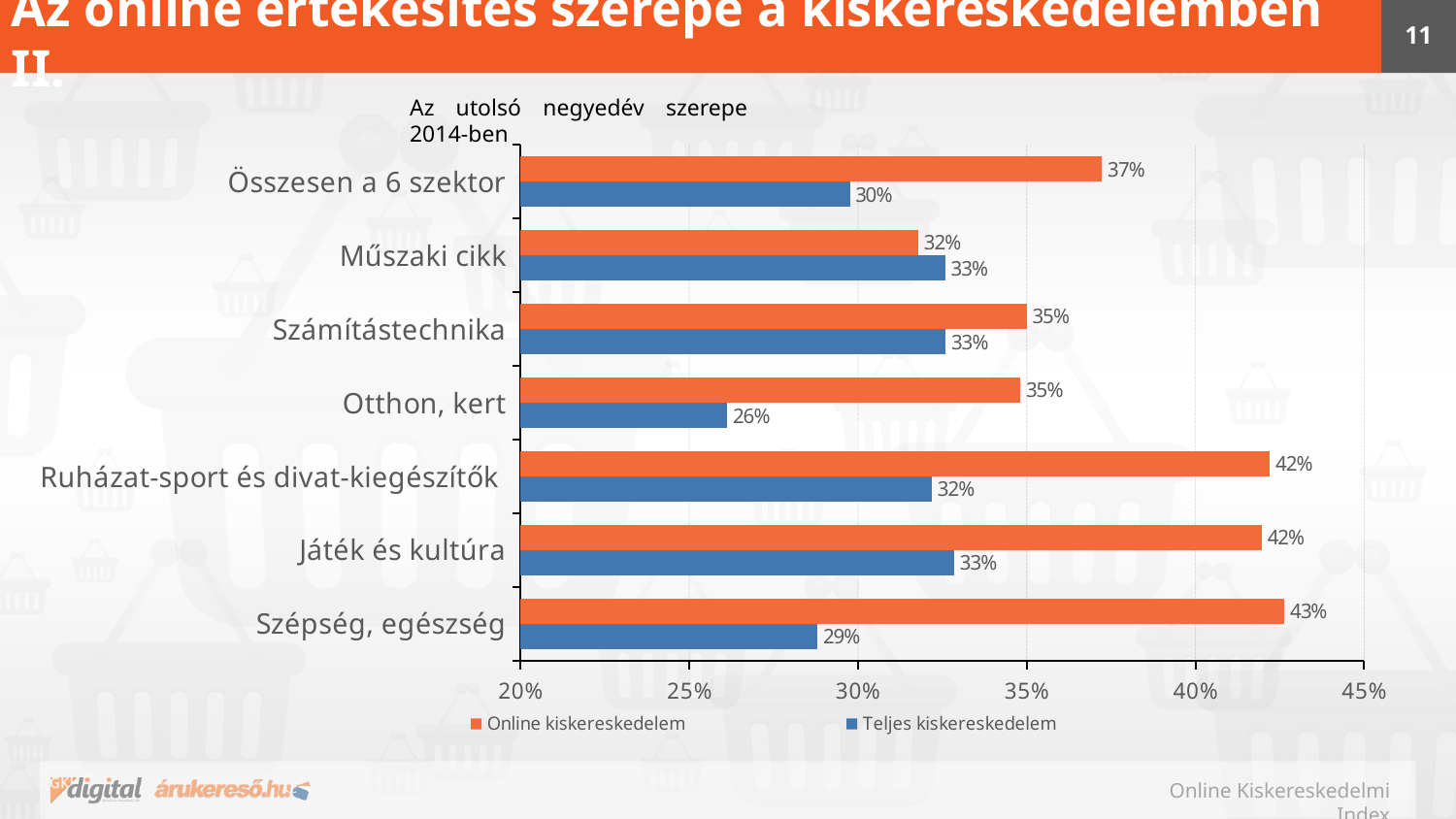
Which category has the lowest Teljes kiskereskedelem value? Otthon, kert Which category has the highest Online kiskereskedelem value? Szépség, egészség For Műszaki cikk, which is larger: Online kiskereskedelem or Teljes kiskereskedelem? Teljes kiskereskedelem What type of chart is shown on the slide? bar chart What is the title of the chart? Az utolsó negyedév szerepe 2014-ben What is the difference between the Online kiskereskedelem and Teljes kiskereskedelem values for Szépség, egészség? 14% What is the Teljes kiskereskedelem value for Otthon, kert? 26% How many categories are shown on the chart? 7 How many series does the legend list? 2 What is the Online kiskereskedelem value for Szépség, egészség? 43% What is the Online kiskereskedelem value for Összesen a 6 szektor? 37% Which category has the lowest Online kiskereskedelem value? Műszaki cikk